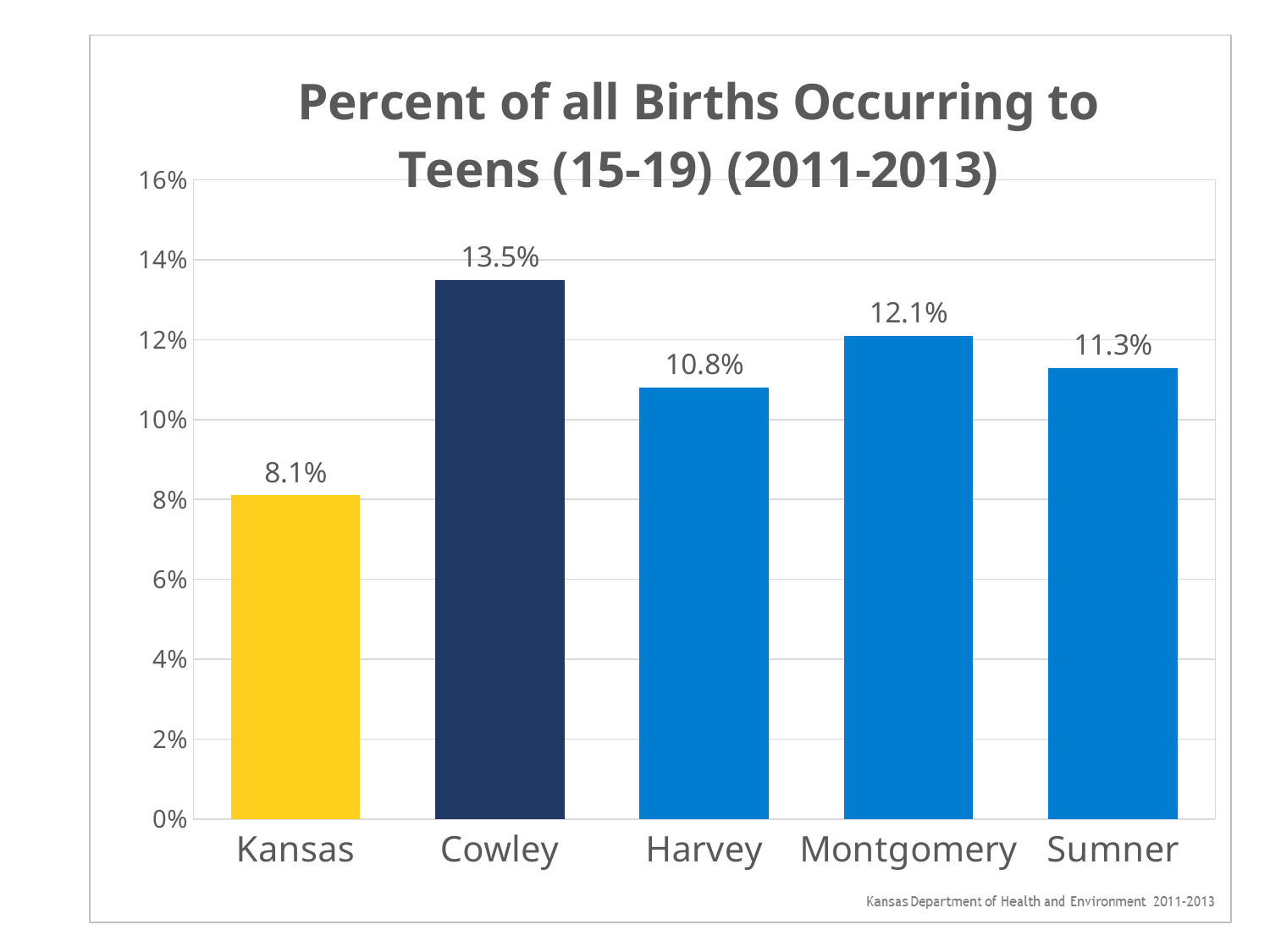
What is the value for Cowley? 13.5% What is the difference between the values for Cowley and Kansas? 5.4% What kind of chart is shown on the slide? bar chart Which category has the lowest value? Kansas What is the value for Kansas? 8.1% How many categories are shown on the x axis? 5 Is the value for Harvey greater or less than 12%? less What is the difference between the values for Montgomery and Harvey? 1.3% What is the value for Montgomery? 12.1% What is the title of the chart? Percent of all Births Occurring to Teens (15-19) (2011-2013) Which category has the highest value? Cowley Which is larger, the value for Sumner or the value for Harvey? Sumner